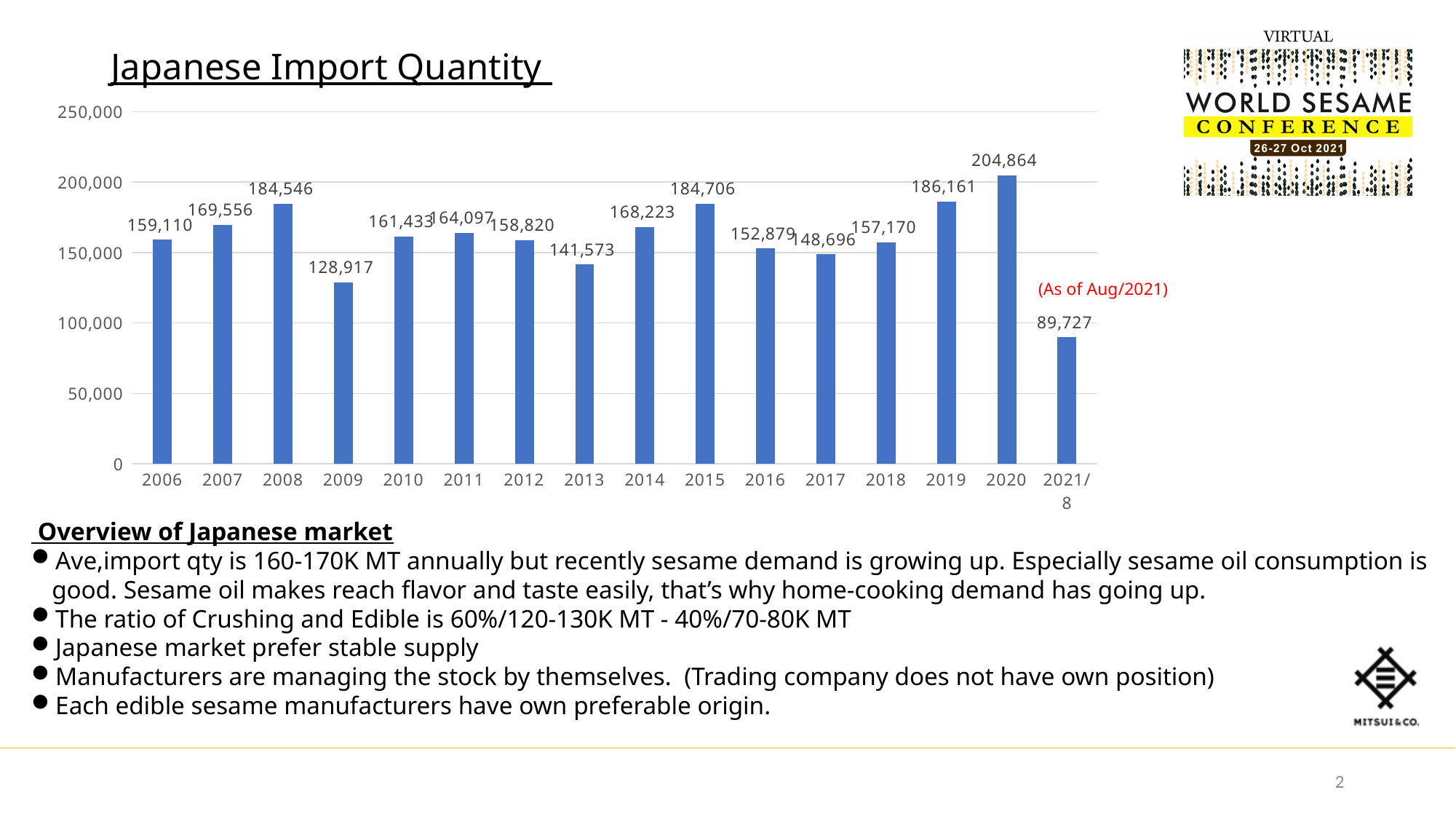
What is the value shown for 2021/8? 89,727 What is the value shown for 2009? 128,917 Is the value for 2013 greater or less than 150,000? less What is the difference between the values for 2013 and 2009? 12,656 What kind of chart is shown on the slide? bar chart What is the difference between the values for 2020 and 2019? 18,703 What is the Japanese import quantity shown for 2020? 204,864 How many categories are shown on the x axis? 16 Which year has the highest import quantity? 2020 Which is larger, the value for 2014 or the value for 2016? 2014 Do the values rise or fall from 2017 to 2020? rise Which category has the lowest value on the chart? 2021/8